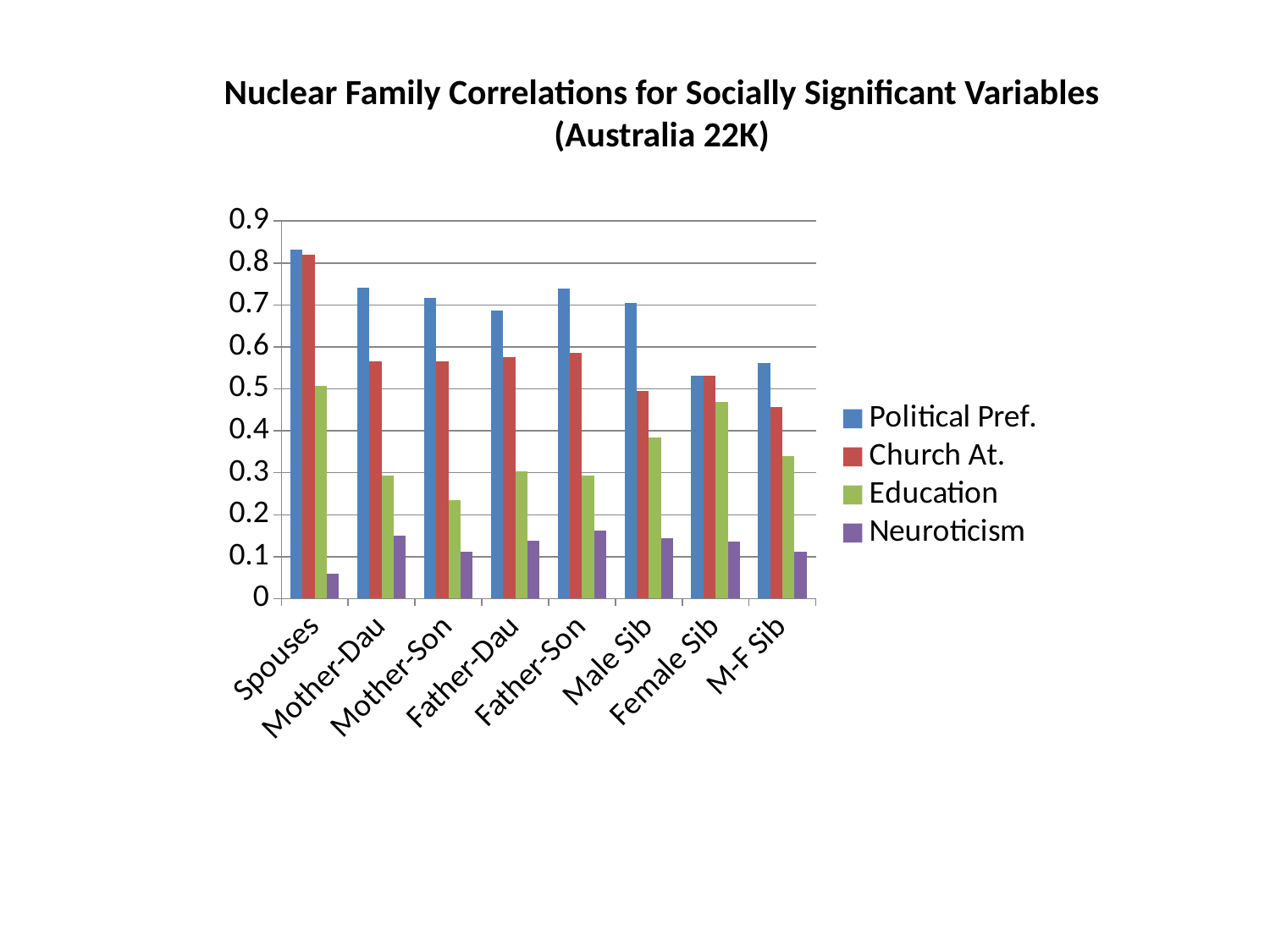
Which category has the lowest Neuroticism correlation? Spouses Is the Neuroticism value for Spouses greater or less than 0.1? less What kind of chart is shown on the slide? bar chart Which category has the highest Political Pref. correlation? Spouses Is the Education value for Female Sib greater or less than 0.4? greater How many series does the legend list? 4 Which category has the highest Church At. correlation? Spouses How many relationship categories are shown on the x axis? 8 What is the title of the chart? Nuclear Family Correlations for Socially Significant Variables (Australia 22K) Which category has the lowest Education correlation? Mother-Son For Male Sib, which is larger: the Political Pref. correlation or the Church At. correlation? Political Pref. Is the Political Pref. value for Spouses greater or less than 0.8? greater